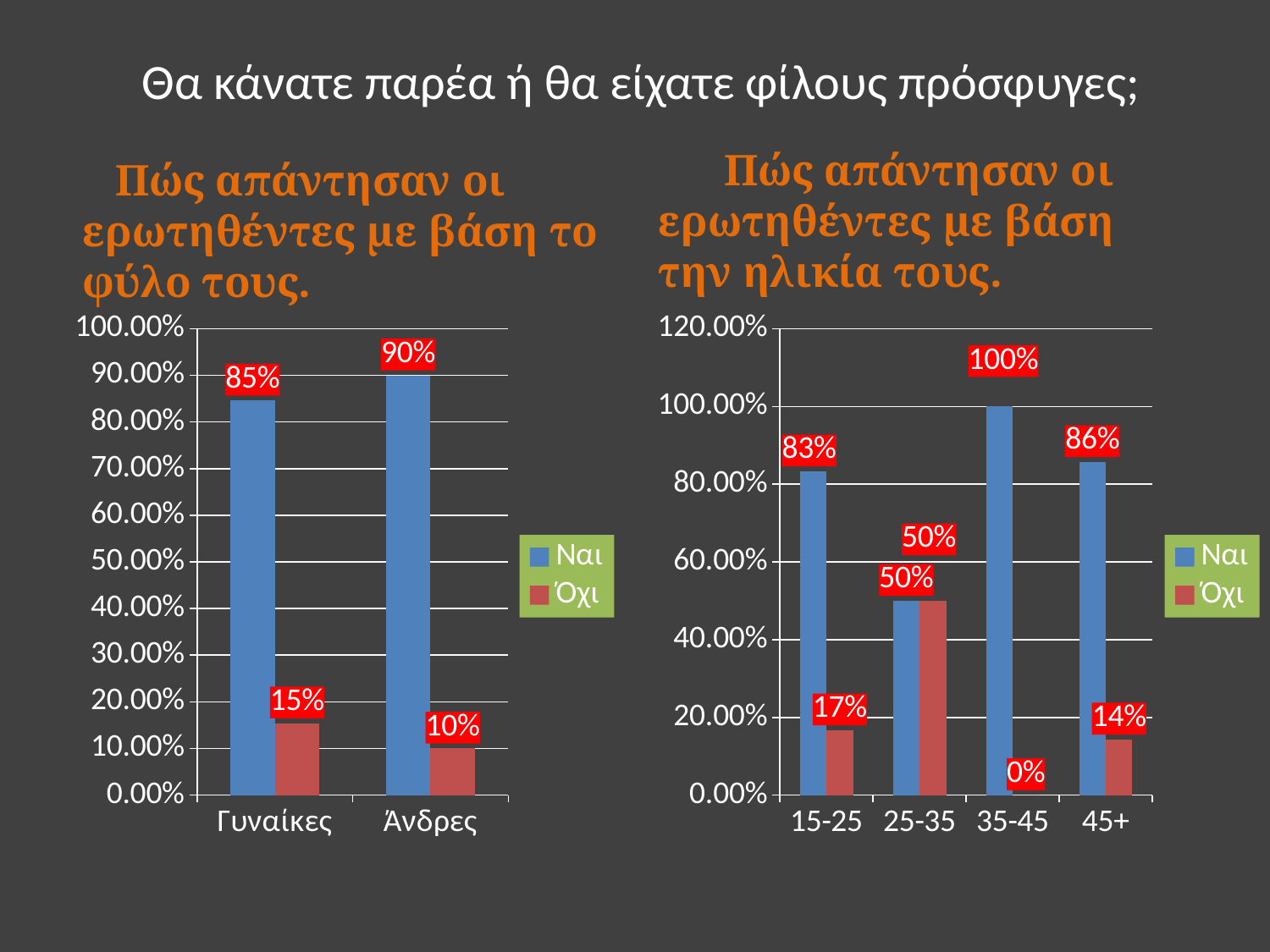
In the right chart (by age), which age group has the lowest Όχι value? 35-45 In the right chart (by age), which age group has the highest Ναι value? 35-45 In the left chart (by gender), which category has the higher Όχι value? Γυναίκες In the right chart (by age), what is the value of Όχι for the 45+ group? 14% In the left chart (by gender), what is the value of Ναι for Γυναίκες? 85% In the right chart (by age), what is the value of Ναι for the 15-25 group? 83% In the left chart (by gender), what is the value of Όχι for Άνδρες? 10% In the left chart (by gender), what is the difference between the Ναι values for Άνδρες and Γυναίκες? 5% In the right chart (by age), what is the difference between the Ναι and Όχι values for the 15-25 group? 66% What type of chart is the right chart (by age)? Bar chart In the right chart (by age), how many series does the legend list? 2 In the left chart (by gender), how many categories are shown on the x axis? 2